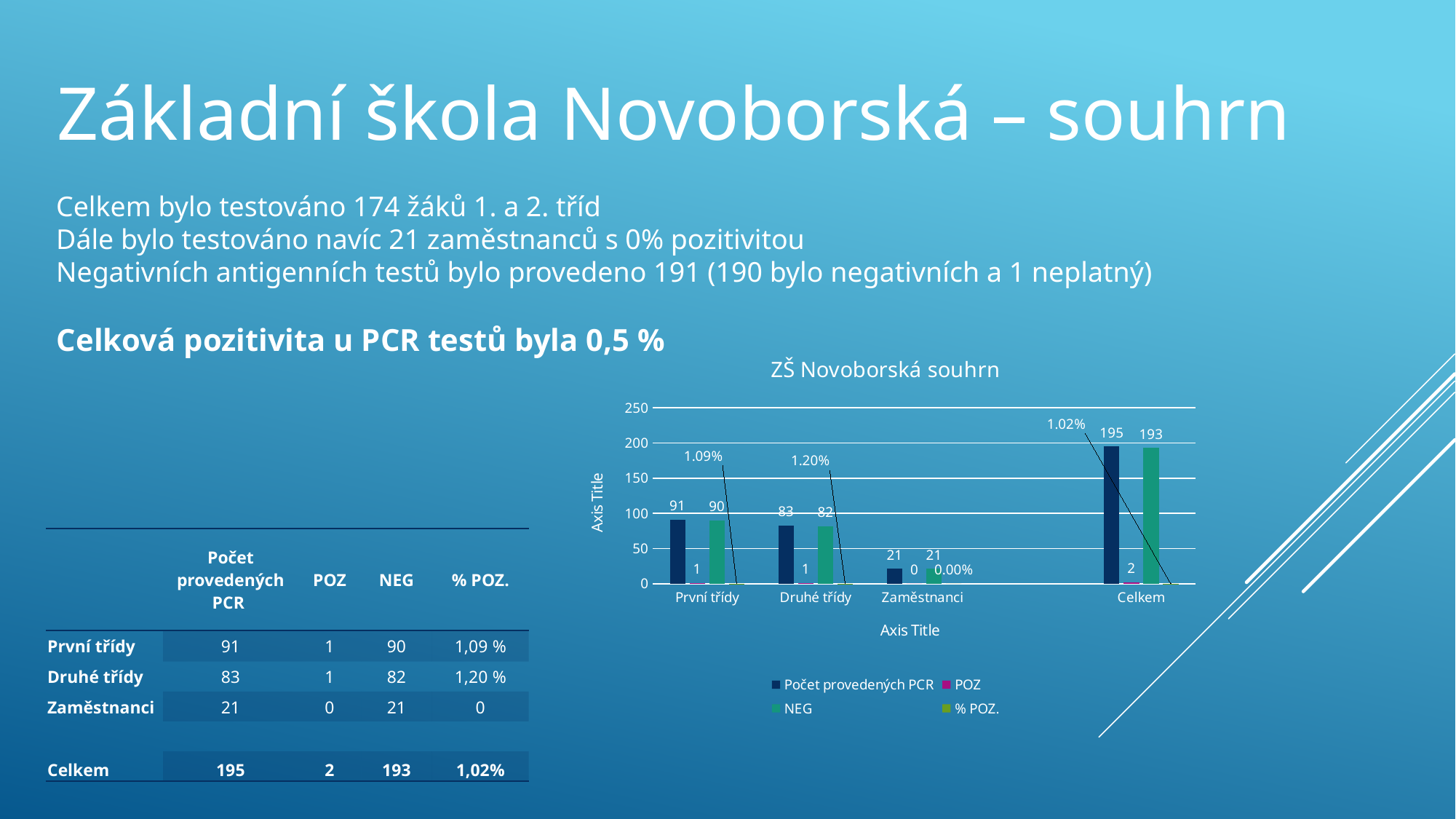
What is the title of the chart? ZŠ Novoborská souhrn Which category has the lowest NEG value? Zaměstnanci What is the value of Počet provedených PCR for První třídy? 91 Which is larger, the NEG value for První třídy or the NEG value for Druhé třídy? První třídy What is the difference between the Počet provedených PCR values for První třídy and Druhé třídy? 8 Which category has the highest Počet provedených PCR value? Celkem How many series does the chart legend list? 4 What is the NEG value for Druhé třídy? 82 What is the % POZ. value shown for Zaměstnanci? 0.00% What is the % POZ. value shown for Druhé třídy? 1.20% What is the POZ value for Celkem? 2 What type of chart is shown on the slide? bar chart